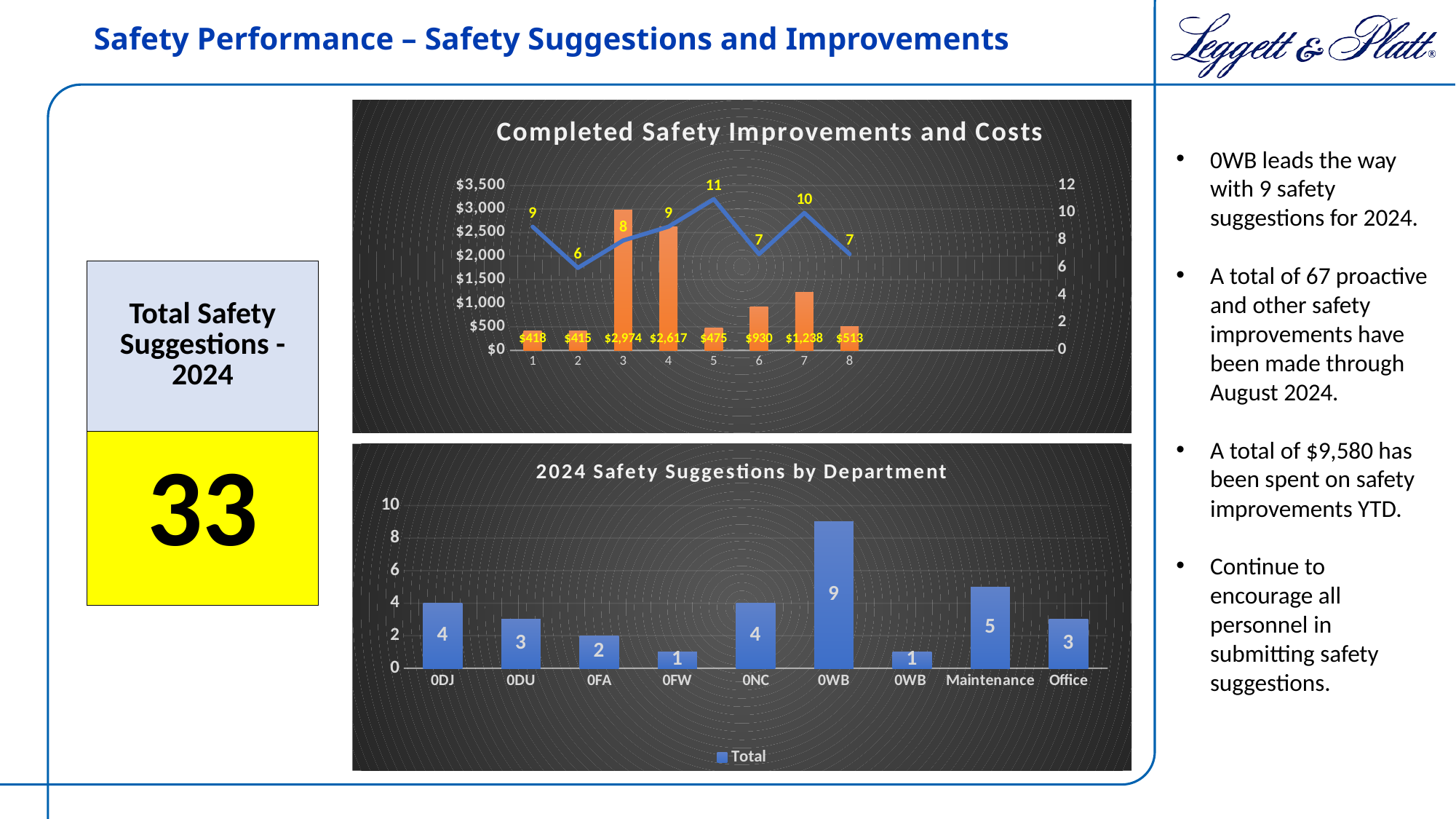
In the '2024 Safety Suggestions by Department' chart, which is larger, the value for 0DJ or the value for 0FA? 0DJ In the 'Completed Safety Improvements and Costs' chart, what is the cost shown for category 7? $1,238 In the 'Completed Safety Improvements and Costs' chart, how many categories are shown on the x axis? 8 In the 'Completed Safety Improvements and Costs' chart, which category has the highest cost bar? 3 In the 'Completed Safety Improvements and Costs' chart, what is the line value shown for category 5? 11 In the '2024 Safety Suggestions by Department' chart, which department has the highest value? 0WB What kind of chart is the '2024 Safety Suggestions by Department' chart? Bar chart In the 'Completed Safety Improvements and Costs' chart, what is the difference between the costs for category 3 and category 4? $357 In the '2024 Safety Suggestions by Department' chart, what is the difference between the values for Maintenance and Office? 2 In the '2024 Safety Suggestions by Department' chart, what is the value for Maintenance? 5 In the 'Completed Safety Improvements and Costs' chart, which category has the lowest cost bar? 2 In the 'Completed Safety Improvements and Costs' chart, what is the cost shown for category 3? $2,974